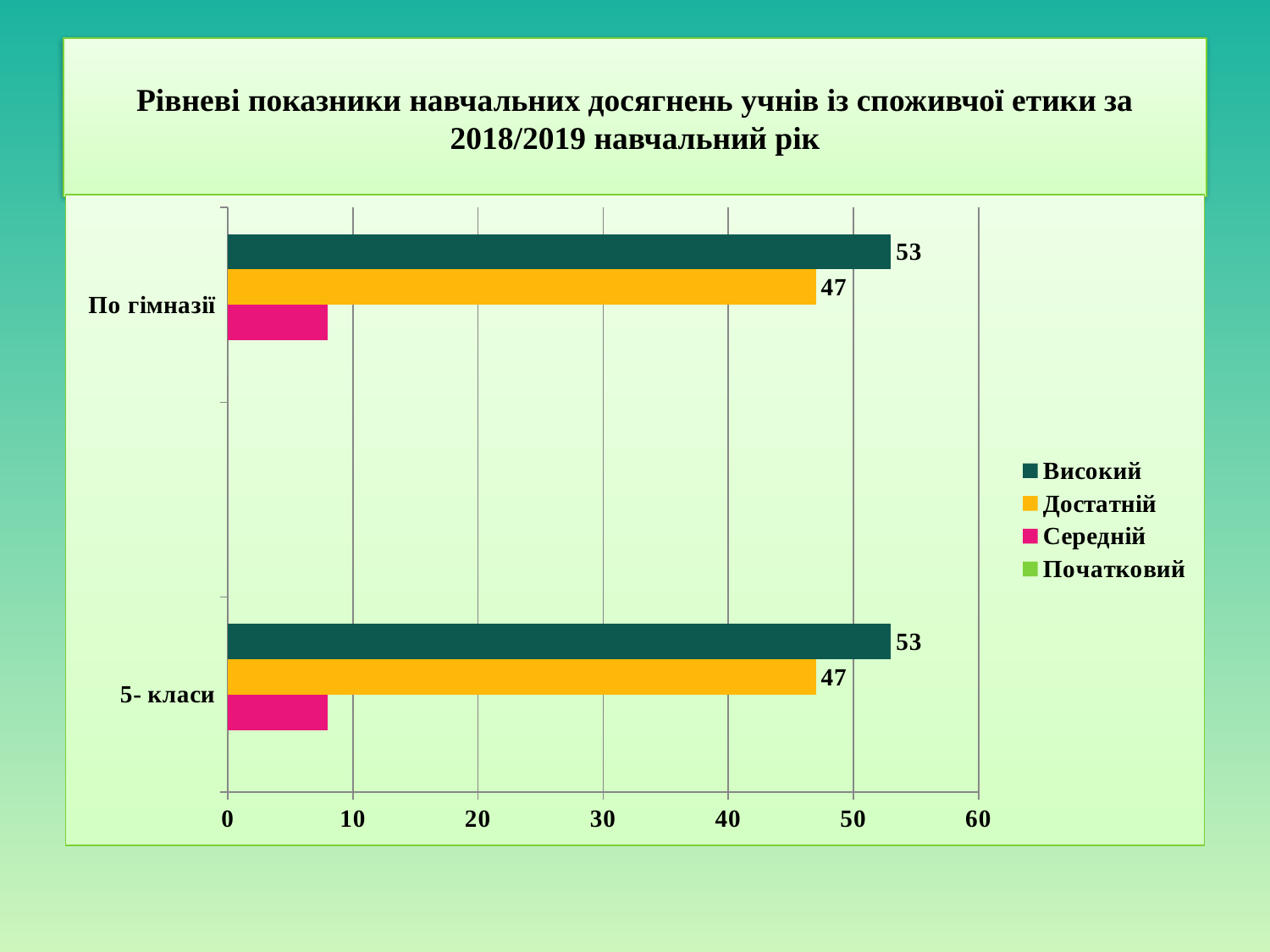
Is the value for Середній for 5- класи greater or less than 10? less Which is larger for По гімназії, Високий or Середній? Високий What is the value for Високий for По гімназії? 53 What kind of chart is shown on the slide? bar chart Which series has the highest value for По гімназії? Високий How many categories are shown on the vertical axis? 2 What is the value for Високий for 5- класи? 53 What is the difference between Високий and Достатній for 5- класи? 6 How many series does the legend list? 4 Which colour represents the Достатній series in the legend? yellow/orange What is the value for Достатній for 5- класи? 47 What is the value for Достатній for По гімназії? 47